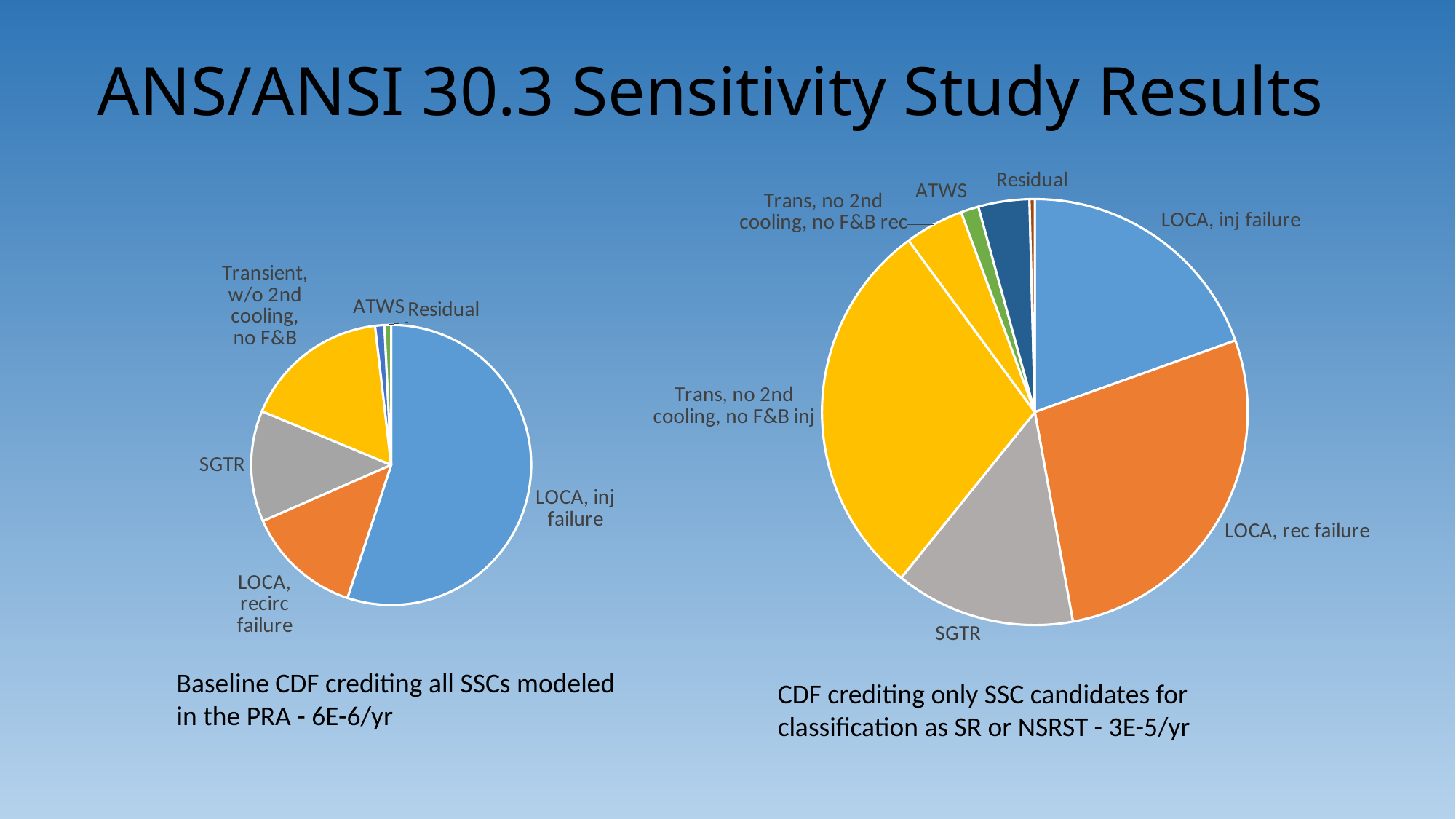
In the right pie chart (CDF crediting only SSC candidates), how many slices are there? 8 In the right pie chart (CDF crediting only SSC candidates), which category has the smallest slice? Residual In the left pie chart (Baseline CDF), which slice is larger: SGTR or LOCA, inj failure? LOCA, inj failure In the right pie chart (CDF crediting only SSC candidates), which category has the largest slice? Trans, no 2nd cooling, no F&B inj In the right pie chart (CDF crediting only SSC candidates), which slice is larger: LOCA, rec failure or SGTR? LOCA, rec failure What kind of chart is the right chart on the slide? Pie chart In the right pie chart (CDF crediting only SSC candidates), which slice is larger: ATWS or LOCA, inj failure? LOCA, inj failure What CDF value is given in the caption of the left pie chart (Baseline CDF crediting all SSCs modeled in the PRA)? 6E-6/yr What CDF value is given in the caption of the right pie chart (CDF crediting only SSC candidates for classification as SR or NSRST)? 3E-5/yr What kind of chart is the left chart on the slide? Pie chart In the left pie chart (Baseline CDF), how many slices are there? 6 In the left pie chart (Baseline CDF), which category has the largest slice? LOCA, inj failure